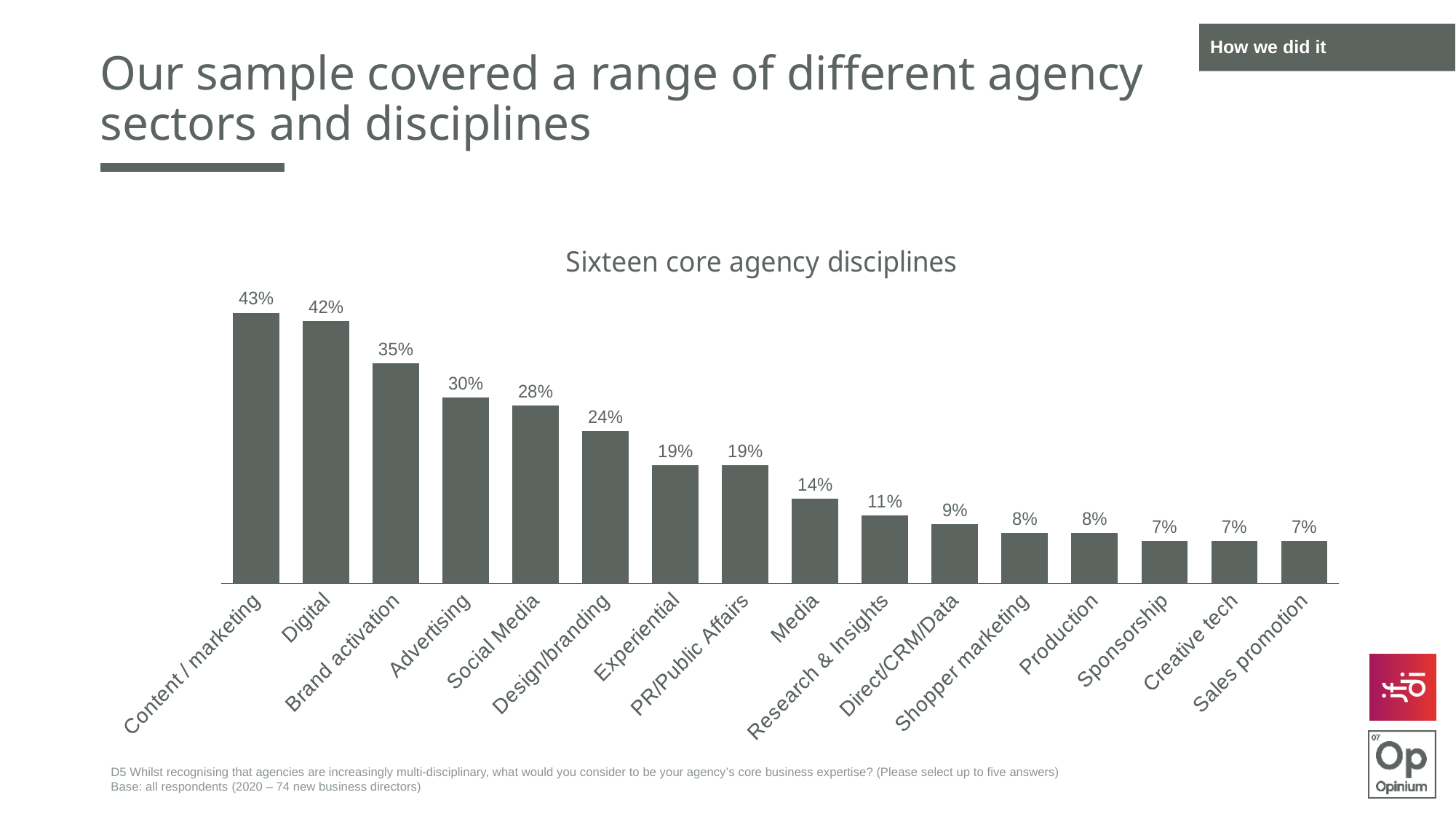
What is the difference between Content / marketing and Brand activation? 8% What is the value for Design/branding? 24% Which discipline has the highest value? Content / marketing What is the difference between Advertising and Media? 16% Which is larger, Social Media or Experiential? Social Media What is the title of the chart? Sixteen core agency disciplines What kind of chart is this? Bar chart How many disciplines are shown on the chart? 16 What percentage is shown for Research & Insights? 11% Do the values rise or fall from left to right along the x axis? Fall How many disciplines share the value 7%? 3 What percentage is shown for Digital? 42%